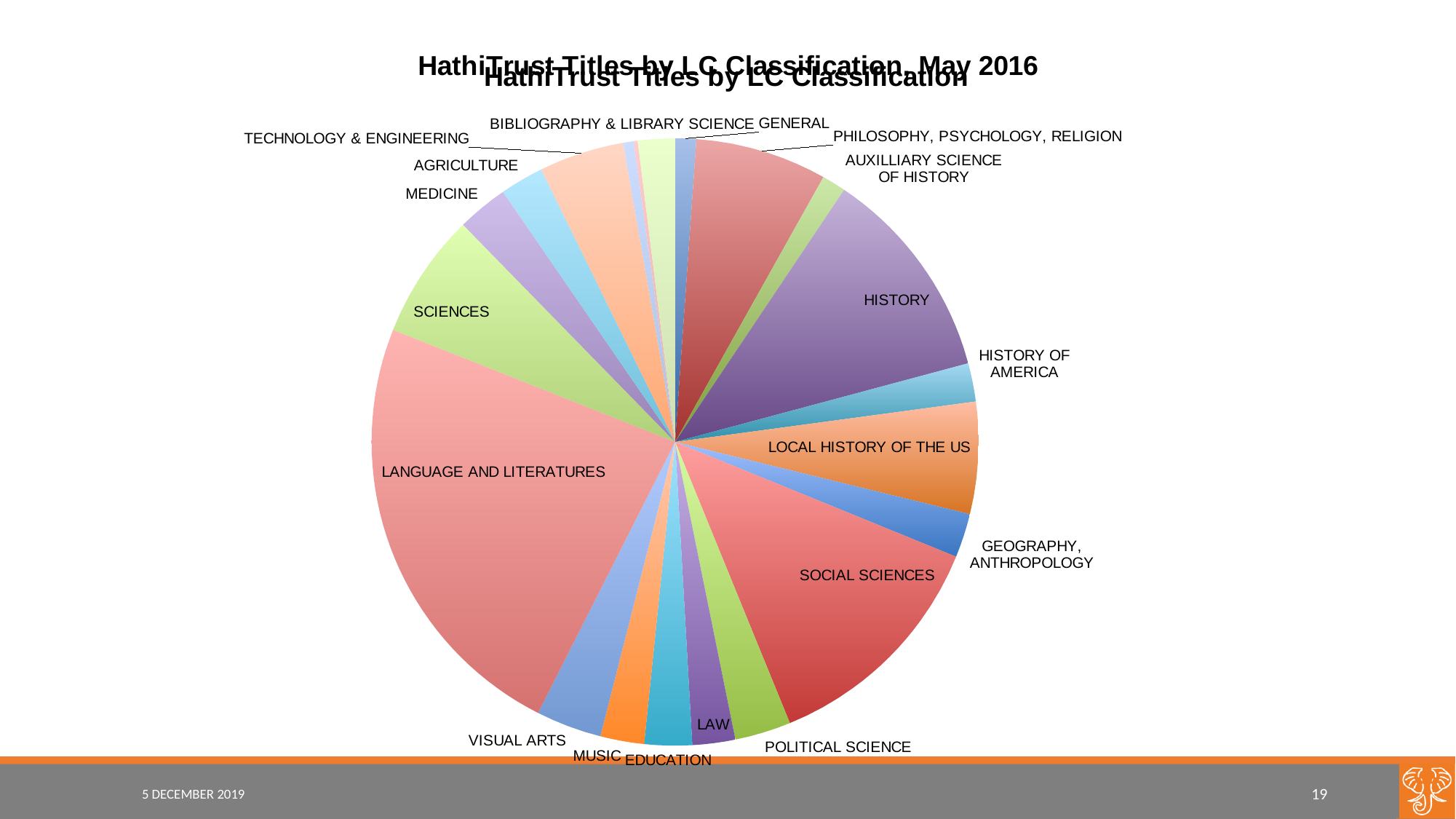
What kind of chart is shown on the slide? pie chart Which slice is larger, SOCIAL SCIENCES or LAW? SOCIAL SCIENCES Which slice is larger, LOCAL HISTORY OF THE US or GEOGRAPHY, ANTHROPOLOGY? LOCAL HISTORY OF THE US Which slice is larger, PHILOSOPHY, PSYCHOLOGY, RELIGION or AUXILLIARY SCIENCE OF HISTORY? PHILOSOPHY, PSYCHOLOGY, RELIGION What is the subject of the chart according to its title? HathiTrust Titles by LC Classification Which LC classification has the largest slice of the pie? LANGUAGE AND LITERATURES What month and year does the chart title say the data is from? May 2016